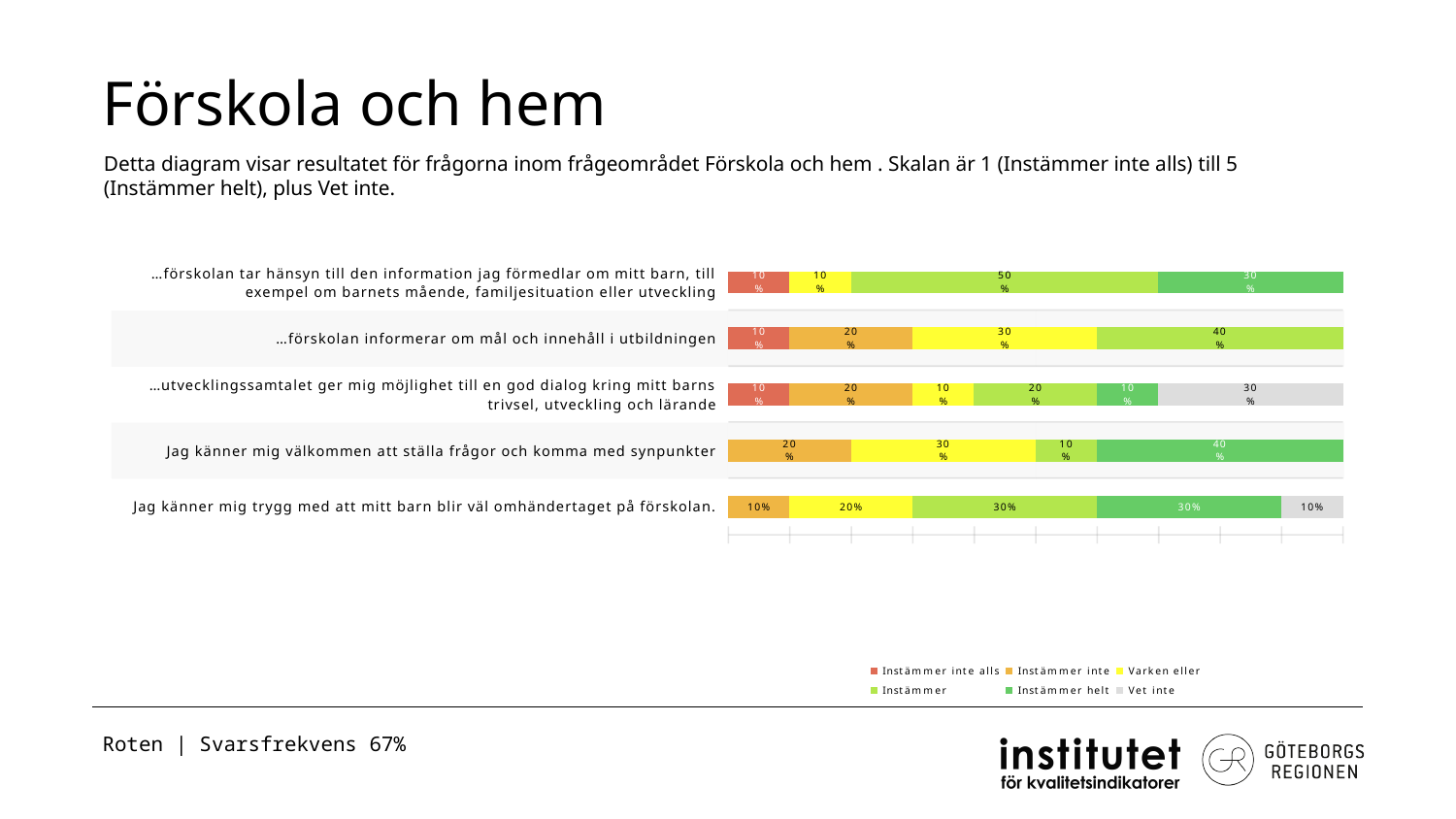
What kind of chart is shown on the slide? stacked bar chart How many question categories are plotted in the chart? 5 What is the first entry listed in the chart legend? Instämmer inte alls What is the value of the 'Instämmer inte' segment for 'Jag känner mig välkommen att ställa frågor och komma med synpunkter'? 20% Which is larger for '…förskolan informerar om mål och innehåll i utbildningen': the 'Instämmer inte' segment or the 'Varken eller' segment? Varken eller What is the value of the 'Vet inte' segment for '…utvecklingssamtalet ger mig möjlighet till en god dialog kring mitt barns trivsel, utveckling och lärande'? 30% What is the value of the 'Varken eller' segment for '…förskolan tar hänsyn till den information jag förmedlar om mitt barn, till exempel om barnets mående, familjesituation eller utveckling'? 10% What is the value of the 'Vet inte' segment for 'Jag känner mig trygg med att mitt barn blir väl omhändertaget på förskolan'? 10% How many series does the legend list? 6 What is the value of the 'Instämmer inte alls' segment for '…förskolan informerar om mål och innehåll i utbildningen'? 10%